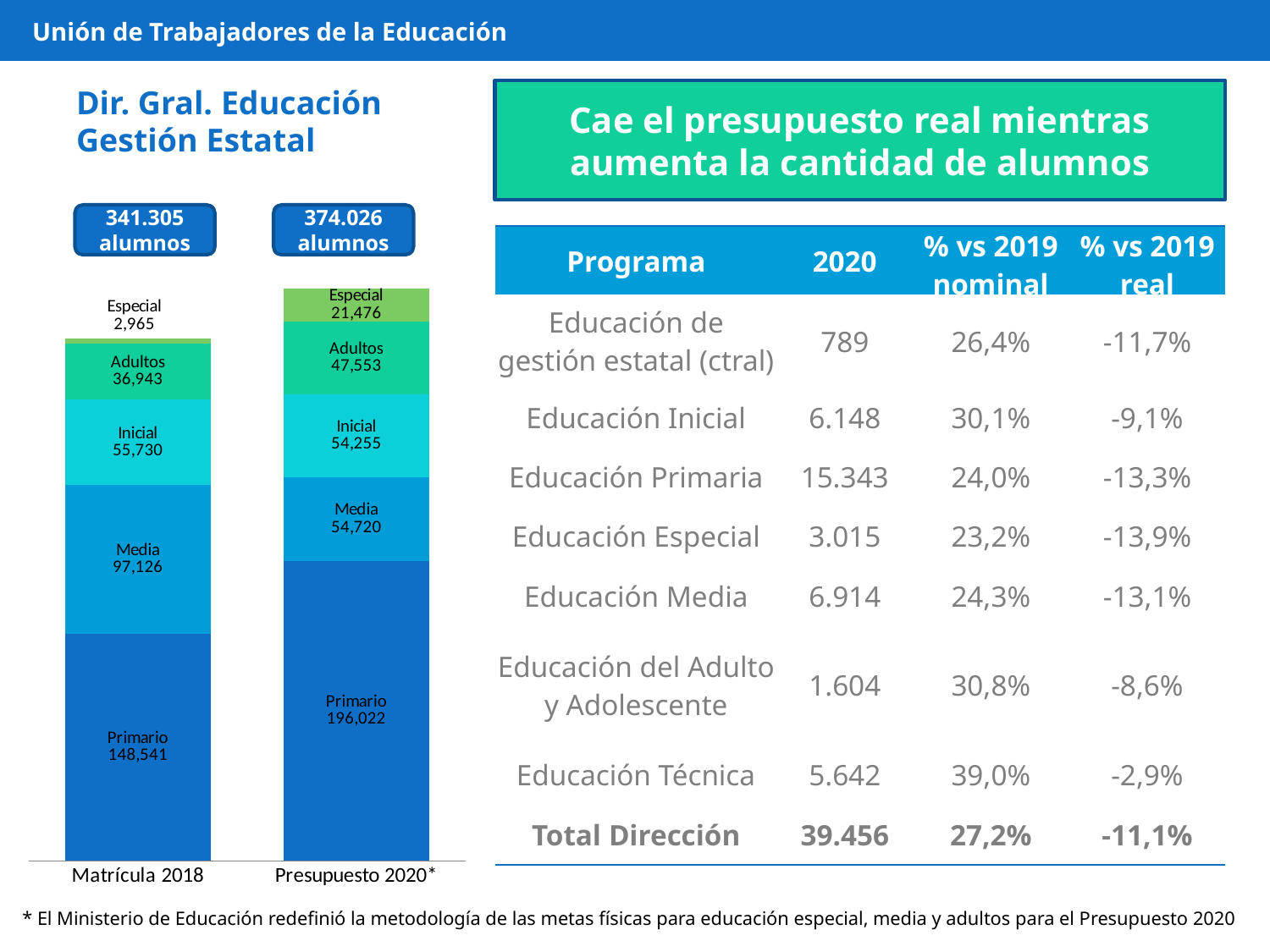
What type of chart is shown on the left of the slide? Stacked bar chart Which segment is the smallest in the Presupuesto 2020* bar? Especial What is the value of the Primario segment in the Matrícula 2018 bar? 148,541 How many bars does the chart show? 2 Which segment is the largest in the Matrícula 2018 bar? Primario Is the Adultos value larger in Matrícula 2018 or in Presupuesto 2020*? Presupuesto 2020* What is the value of the Media segment in the Presupuesto 2020* bar? 54,720 What is the value of the Adultos segment in the Presupuesto 2020* bar? 47,553 What is the total number of alumnos shown for the Matrícula 2018 bar? 341.305 alumnos How many segments make up each bar in the chart? 5 What is the difference between the Primario value in Presupuesto 2020* and in Matrícula 2018? 47,481 What is the value of the Especial segment in the Matrícula 2018 bar? 2,965